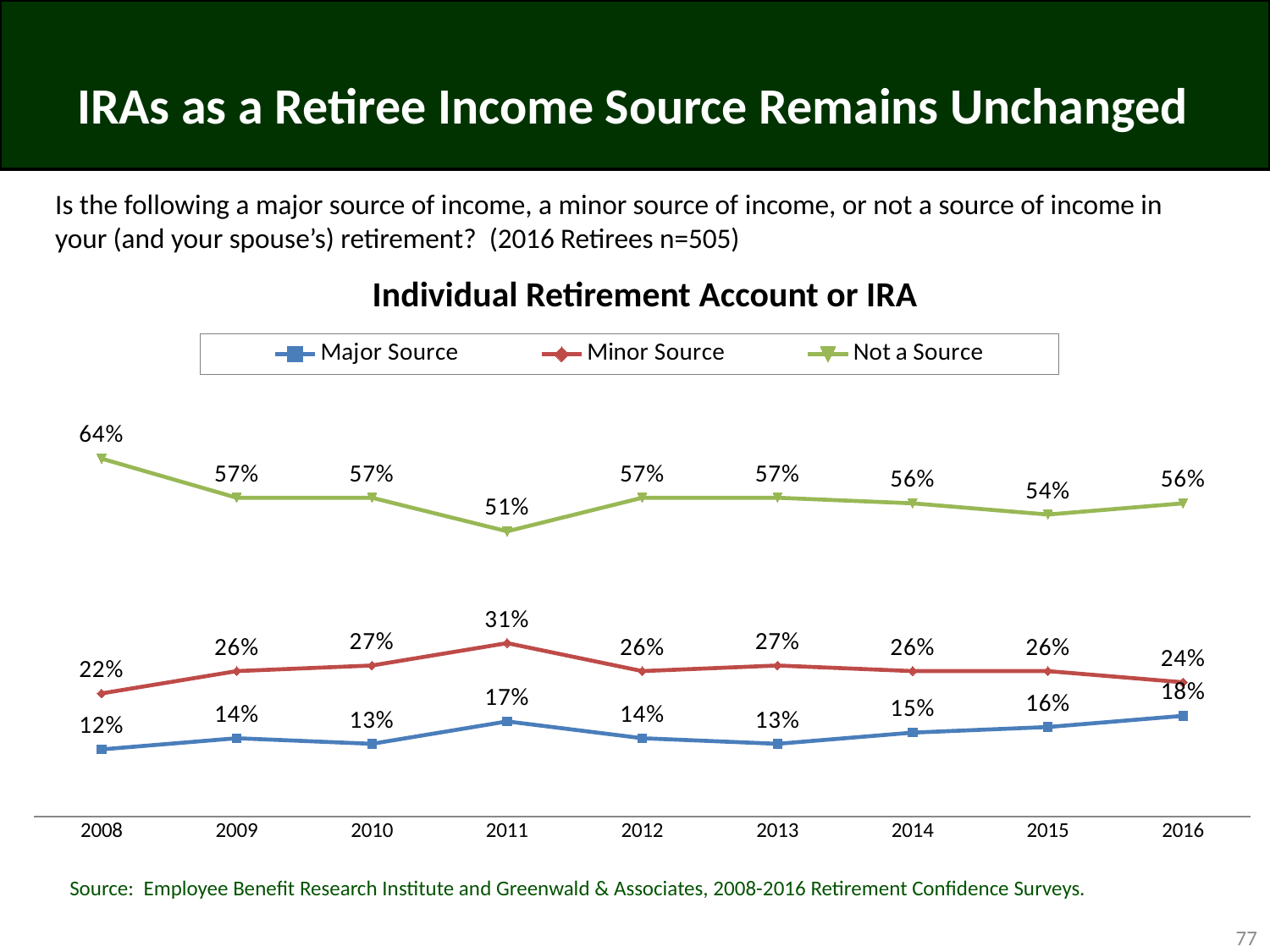
In which year is the Minor Source value highest? 2011 In which year is the Not a Source value lowest? 2011 What is the difference between the Not a Source value in 2008 and in 2016? 8% Does the Major Source series rise or fall from 2013 to 2016? Rise How many years are plotted along the x axis? 9 What type of chart is shown on the slide? Line chart What is the value for Not a Source in 2008? 64% What is the value for Major Source in 2011? 17% What is the value for Minor Source in 2016? 24% Which is larger, the Major Source value in 2016 or the Major Source value in 2008? 2016 How many series does the legend list? 3 What is the title of the chart? Individual Retirement Account or IRA